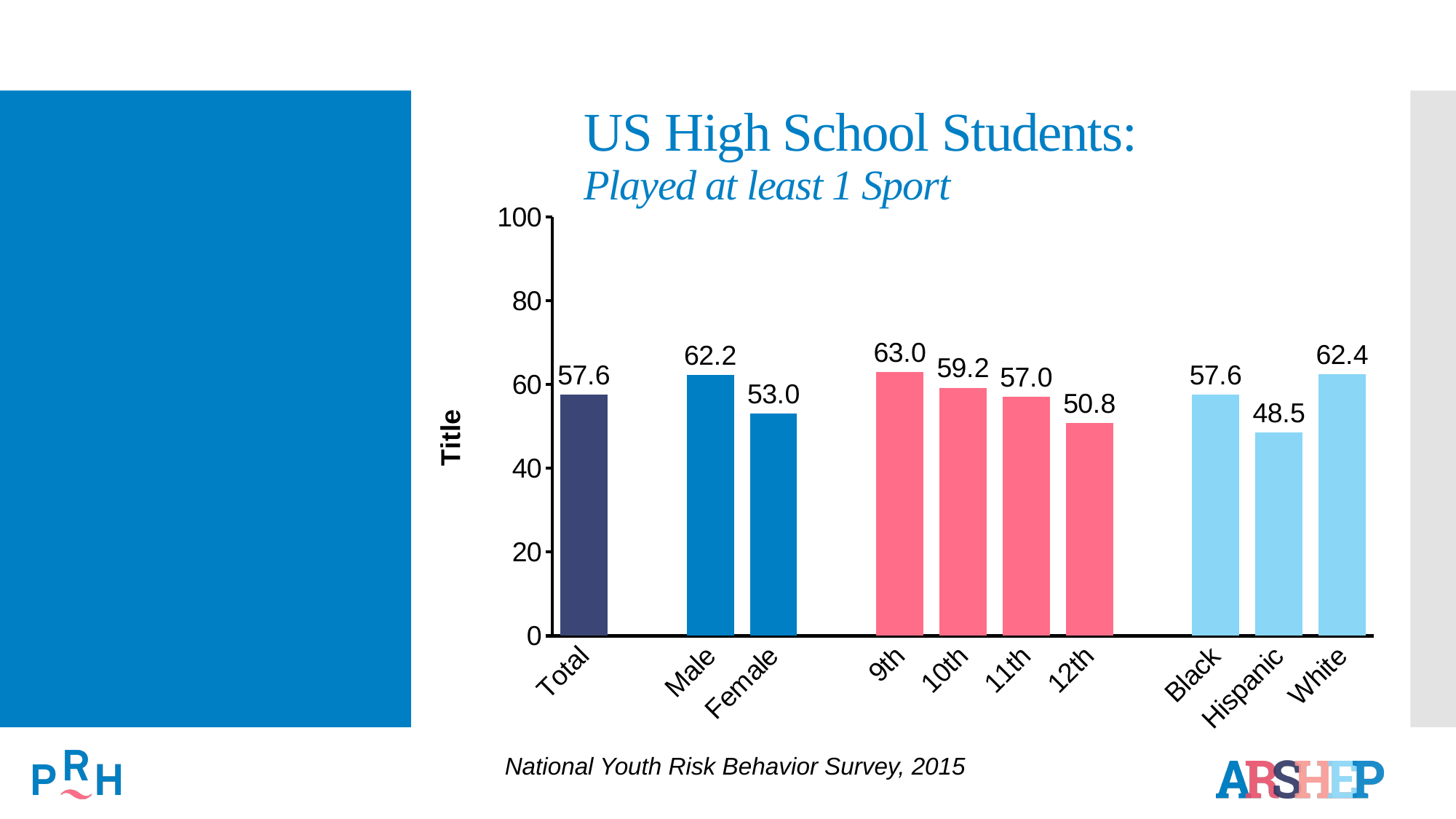
What is the value for Total? 57.6 What is the value for 10th graders? 59.2 Which category has the lowest value? Hispanic What is the value for Hispanic students? 48.5 Do the values rise or fall from 9th grade to 12th grade? fall What kind of chart is this? bar chart What is the subtitle of the chart? Played at least 1 Sport Is the value for 12th graders greater or less than 60? less What is the difference between the Male and Female values? 9.2 How many categories are shown on the x axis? 10 Which is larger, the value for White or the value for Black? White Which category has the highest value? 9th